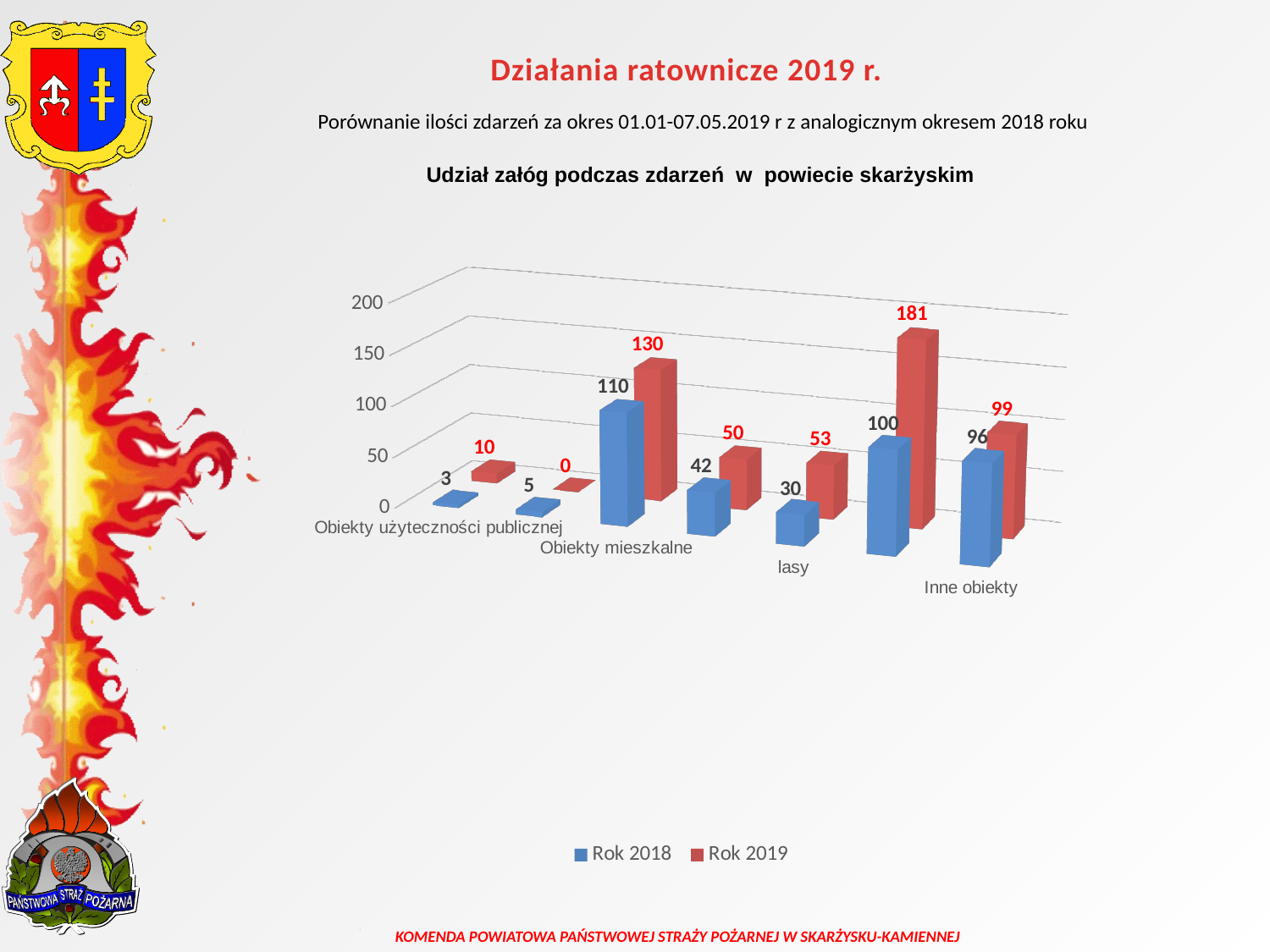
Which category has the highest value for Rok 2018? Obiekty mieszkalne What is the value for Rok 2018 for Inne obiekty? 96 Which category has the lowest value for Rok 2018? Obiekty użyteczności publicznej How many series does the legend list? 2 What kind of chart is shown on the slide? bar chart What is the value for Rok 2018 for Obiekty użyteczności publicznej? 3 What is the value for Rok 2019 for lasy? 53 What is the highest value shown for the Rok 2019 series? 181 What is the difference between the Rok 2019 and Rok 2018 values for lasy? 23 What is the value for Rok 2019 for Obiekty mieszkalne? 130 What is the value for Rok 2018 for Obiekty mieszkalne? 110 For Obiekty użyteczności publicznej, which is larger: the Rok 2018 value or the Rok 2019 value? Rok 2019